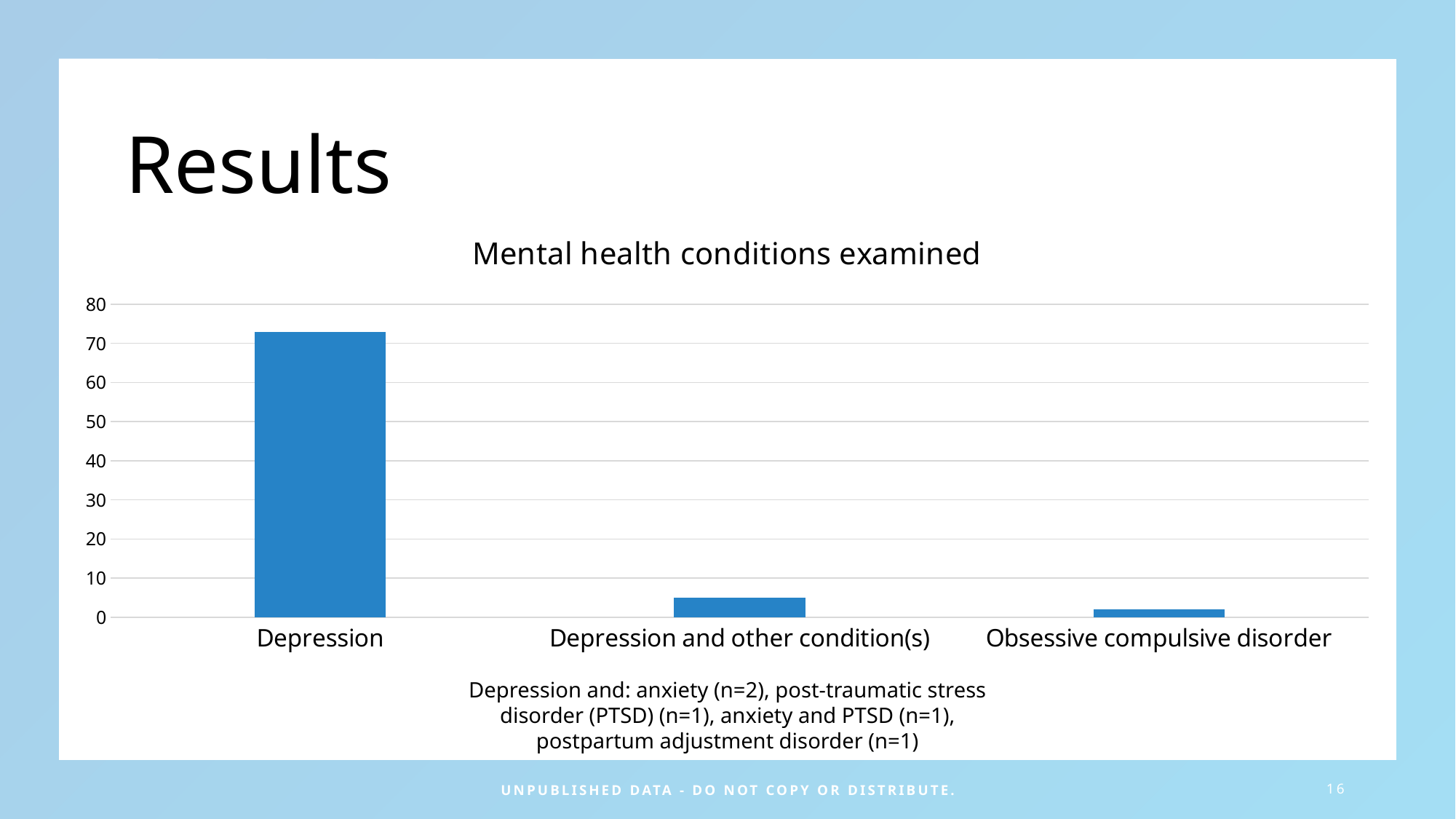
Which is larger, the value for Depression and other condition(s) or the value for Obsessive compulsive disorder? Depression and other condition(s) Which category has the highest value in the chart? Depression What is the title of the chart? Mental health conditions examined Which is larger, the value for Depression or the value for Obsessive compulsive disorder? Depression How many categories are shown on the x axis of the chart? 3 Which category has the lowest value in the chart? Obsessive compulsive disorder Is the value for Depression greater or less than 80? less Is the value for Obsessive compulsive disorder greater or less than 10? less Do the bar values rise or fall from left to right across the x axis? fall Is the value for Depression and other condition(s) greater or less than 10? less What kind of chart is shown on the slide? bar chart